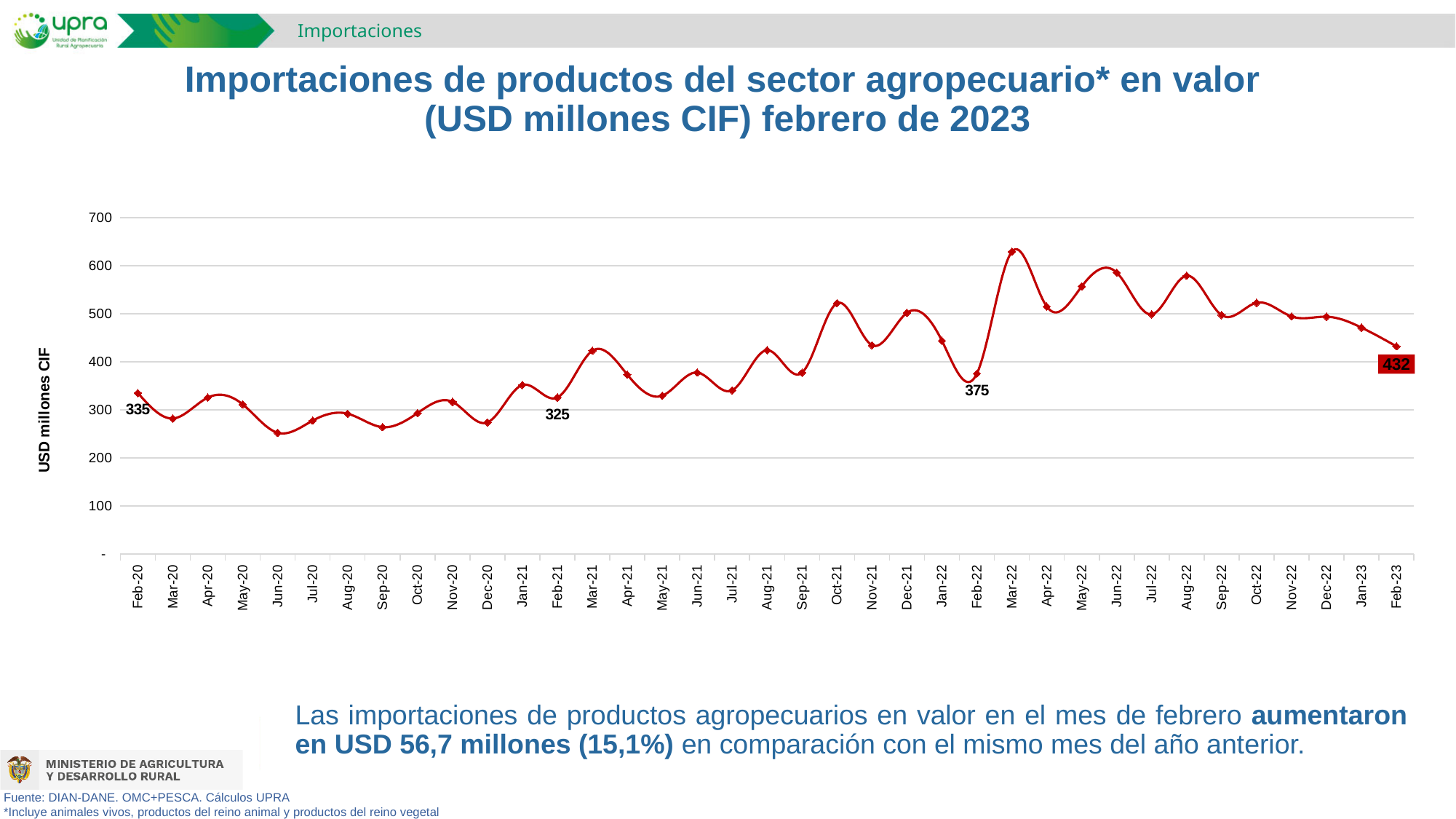
Is the value for Jun-20 greater or less than 300? less What is the value for Feb-22? 375 What type of chart is shown on the slide? Line chart Which month has the highest value on the chart? Mar-22 Which is larger, the value for Feb-23 or the value for Feb-20? Feb-23 What is the value for Feb-20? 335 What is the value for Feb-21? 325 What is the label of the vertical axis? USD millones CIF What is the difference between the values for Feb-23 and Feb-22? 57 What is the value for Feb-23? 432 What is the difference between the values for Feb-22 and Feb-21? 50 Is the value for Mar-22 greater or less than 600? greater